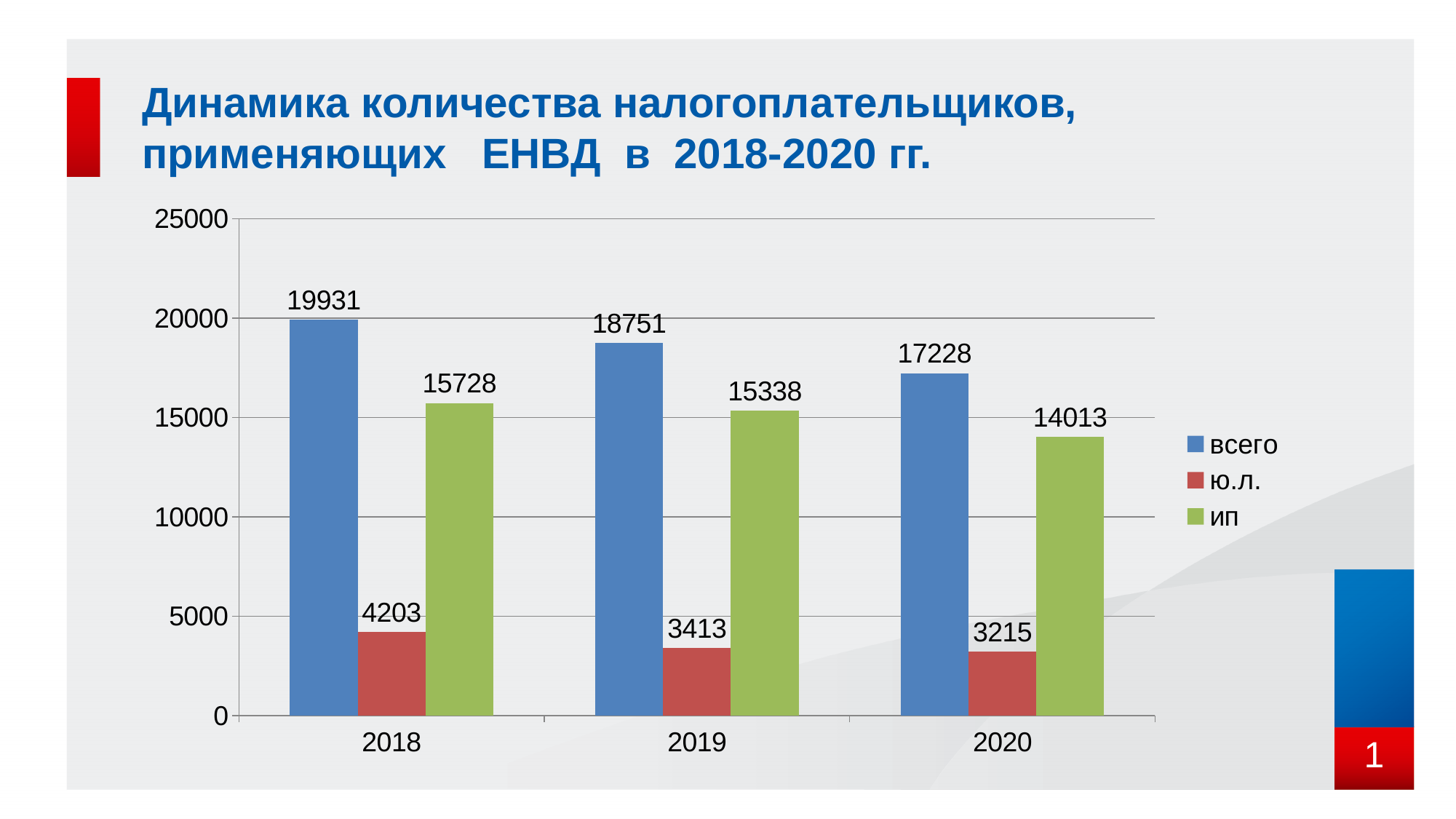
How many years are shown on the x axis? 3 In which year is the "всего" value the highest? 2018 How many series does the legend list? 3 What is the value of the "ип" series for 2020? 14013 What is the value of the "всего" series for 2018? 19931 Which is larger: the "ип" value for 2019 or the "ип" value for 2020? 2019 Do the "всего" values rise or fall from 2018 to 2020? fall What is the value of the "ю.л." series for 2019? 3413 What is the difference between the "всего" values for 2018 and 2020? 2703 In which year is the "ип" value the lowest? 2020 What kind of chart is shown on the slide? bar chart What is the difference between the "ю.л." values for 2018 and 2019? 790